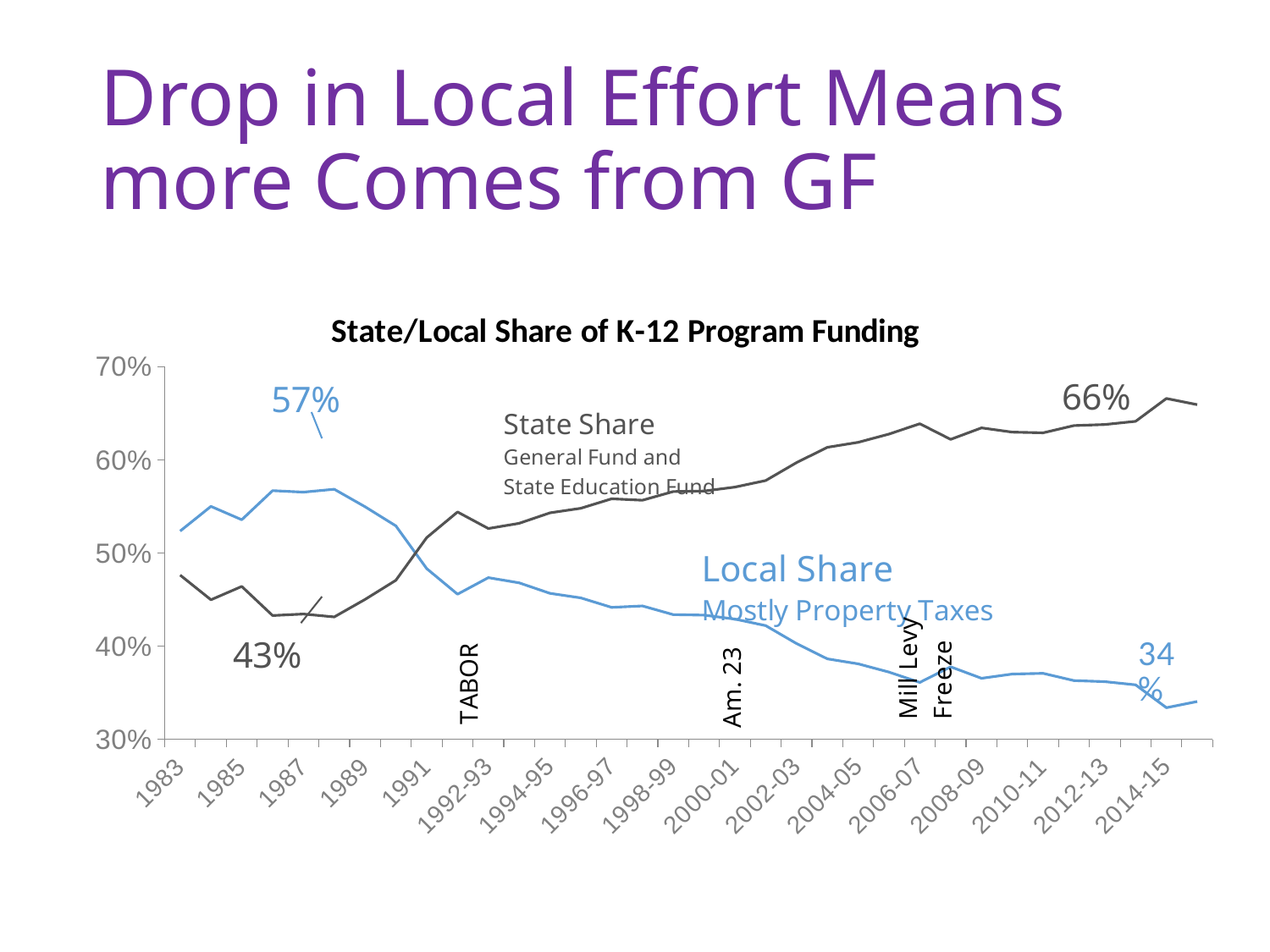
Is the Local Share value for 2014-15 greater or less than 40%? less What is the labelled value of the Local Share line at the right end of the chart? 34% Which event is annotated on the chart near 1992-93? TABOR In 1983, which is larger: the State Share or the Local Share? Local Share What is the title of the chart? State/Local Share of K-12 Program Funding What kind of chart is shown on the slide? Line chart How many series are plotted on the chart? 2 What is the labelled value of the State Share line at the right end of the chart? 66% Does the State Share line generally rise or fall from 1983 to 2014-15? Rise What is the labelled low value of the State Share line in the late 1980s? 43% What is the labelled peak value of the Local Share line in the late 1980s? 57% What is the difference between the labelled State Share (66%) and Local Share (34%) values at the right end of the chart? 32 percentage points